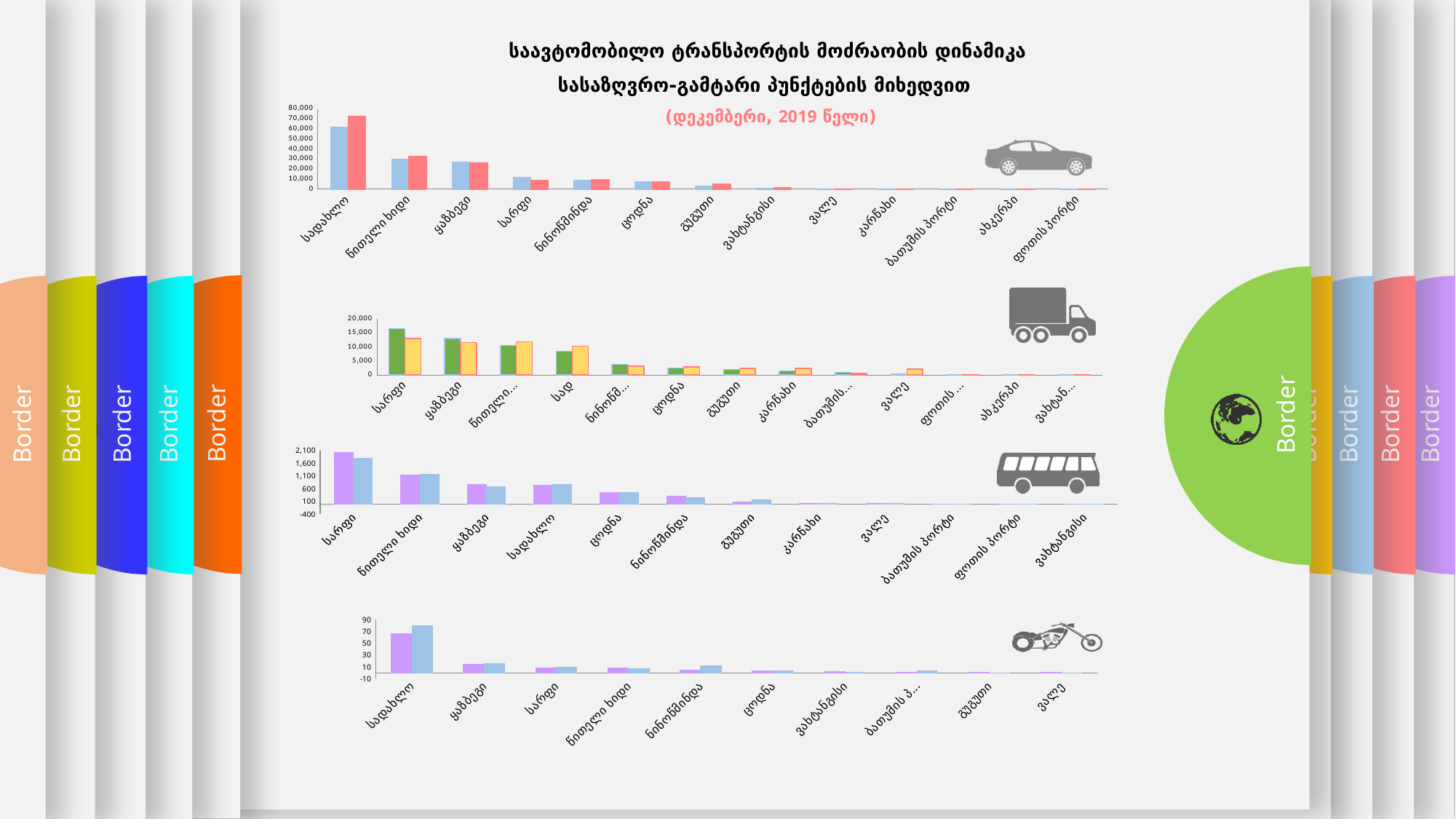
In the top chart (car icon), how many categories are shown on the x axis? 13 In the top chart (car icon), is the blue bar for სადახლო greater or less than 50,000? greater What type of chart is the top chart (with the car icon)? bar chart In the second chart (truck icon), which category has the highest green bar? სარფი In the top chart (car icon), which bar for სადახლო is larger, the blue one or the red one? the red one In the second chart (truck icon), is the green bar for სარფი greater or less than 15,000? greater In the third chart (bus icon), how many categories are shown on the x axis? 12 In the third chart (bus icon), is the purple bar for სარფი greater or less than 1,600? greater In the bottom chart (motorcycle icon), do the values generally rise or fall from left to right along the x axis? fall How many charts are on the slide? 4 In the top chart (car icon), which category has the highest values? სადახლო In the bottom chart (motorcycle icon), which bar for სადახლო is larger, the purple one or the blue one? the blue one